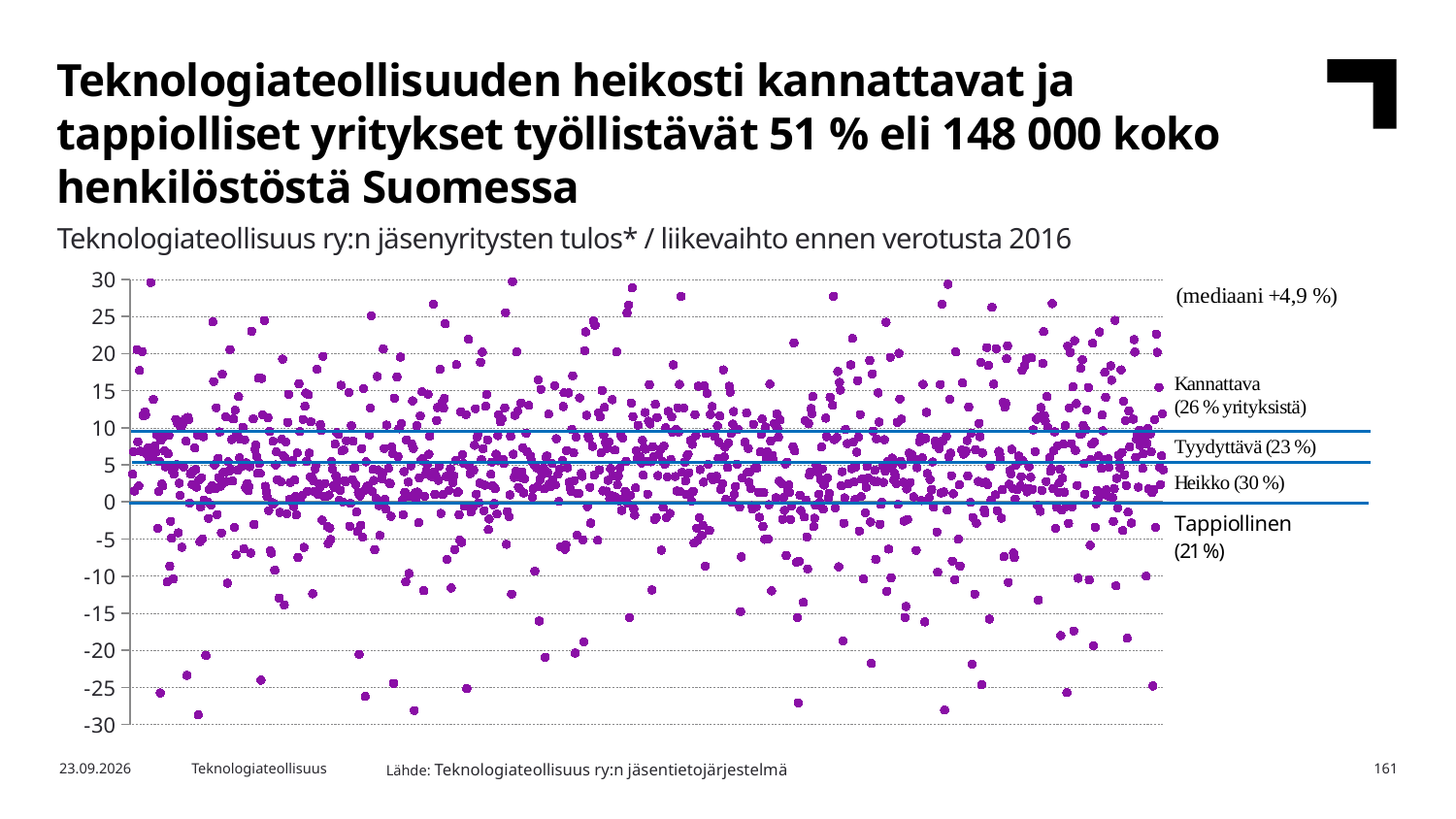
Which profitability category has the largest share of companies? Heikko What kind of chart is shown on the slide? Scatter chart What share of companies is labelled as Kannattava on the chart? 26 % How many profitability categories are labelled on the chart? 4 Which has a larger share of companies, Kannattava or Tyydyttävä? Kannattava What share of companies is labelled as Tappiollinen on the chart? 21 % What median value is stated on the chart? +4,9 % What share of companies is labelled as Tyydyttävä on the chart? 23 % Which profitability category has the smallest share of companies? Tappiollinen What is the highest value shown on the vertical axis? 30 How many percentage points larger is the Heikko share than the Tappiollinen share? 9 What share of companies is labelled as Heikko on the chart? 30 %